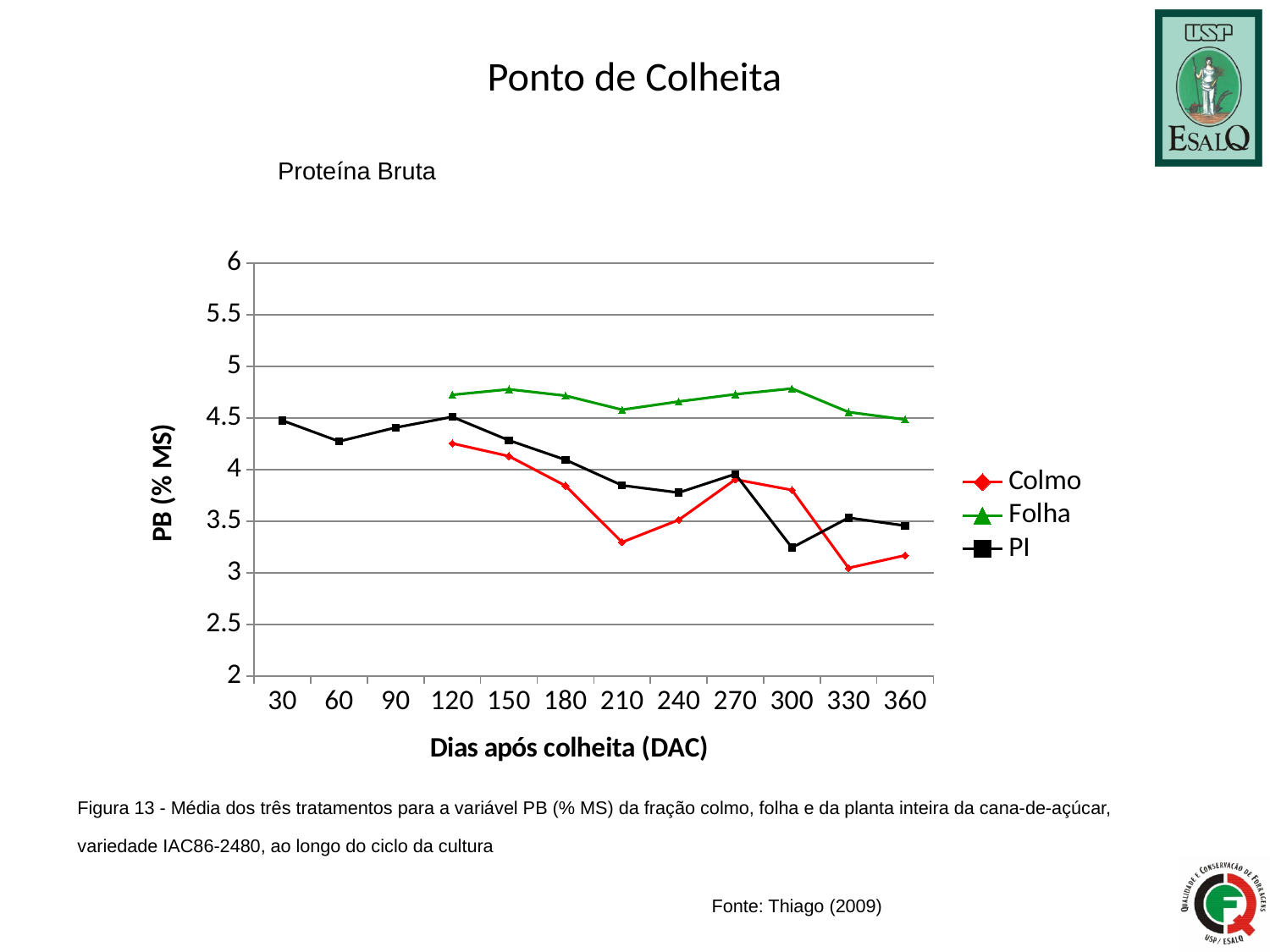
At 120 DAC, which is higher, Folha or PI? Folha What is the title of the y axis? PB (% MS) Is the value for PI at 300 DAC greater or less than 3.5? less At which DAC does the Colmo series reach its lowest value? 330 Is the value for Folha at 150 DAC greater or less than 4.5? greater Does the Colmo series overall rise or fall from 120 DAC to 360 DAC? fall How many DAC points are labelled on the x axis? 12 Which series has the highest value at 360 DAC? Folha How many series does the legend list? 3 At 300 DAC, which is higher, Colmo or PI? Colmo What kind of chart is shown on the slide? line chart Is the value for Colmo at 210 DAC greater or less than 3.5? less